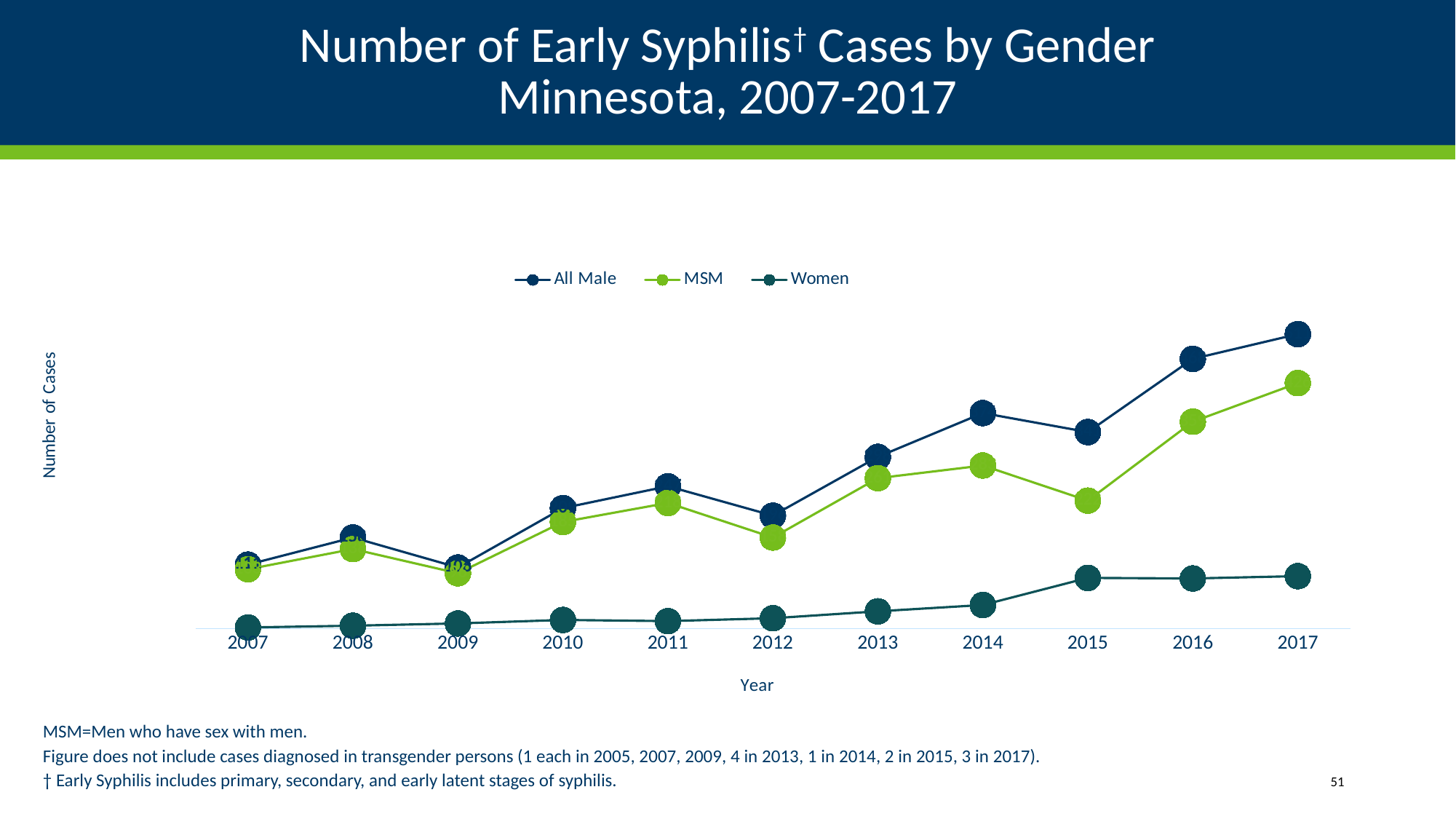
Which is larger in 2012, the MSM value or the Women value? MSM Does the Women series generally rise or fall from 2007 to 2017? rise Does the All Male series rise or fall between 2014 and 2015? fall How many series does the legend list? 3 In which year is the Women series at its lowest? 2007 Which series has the lowest values across all years? Women How many years are plotted along the x axis? 11 In which year is the All Male series at its highest? 2017 What are the three series named in the legend? All Male, MSM, Women In which year is the MSM series at its highest? 2017 What kind of chart is shown on the slide? line chart Which is larger in 2015, the All Male value or the MSM value? All Male